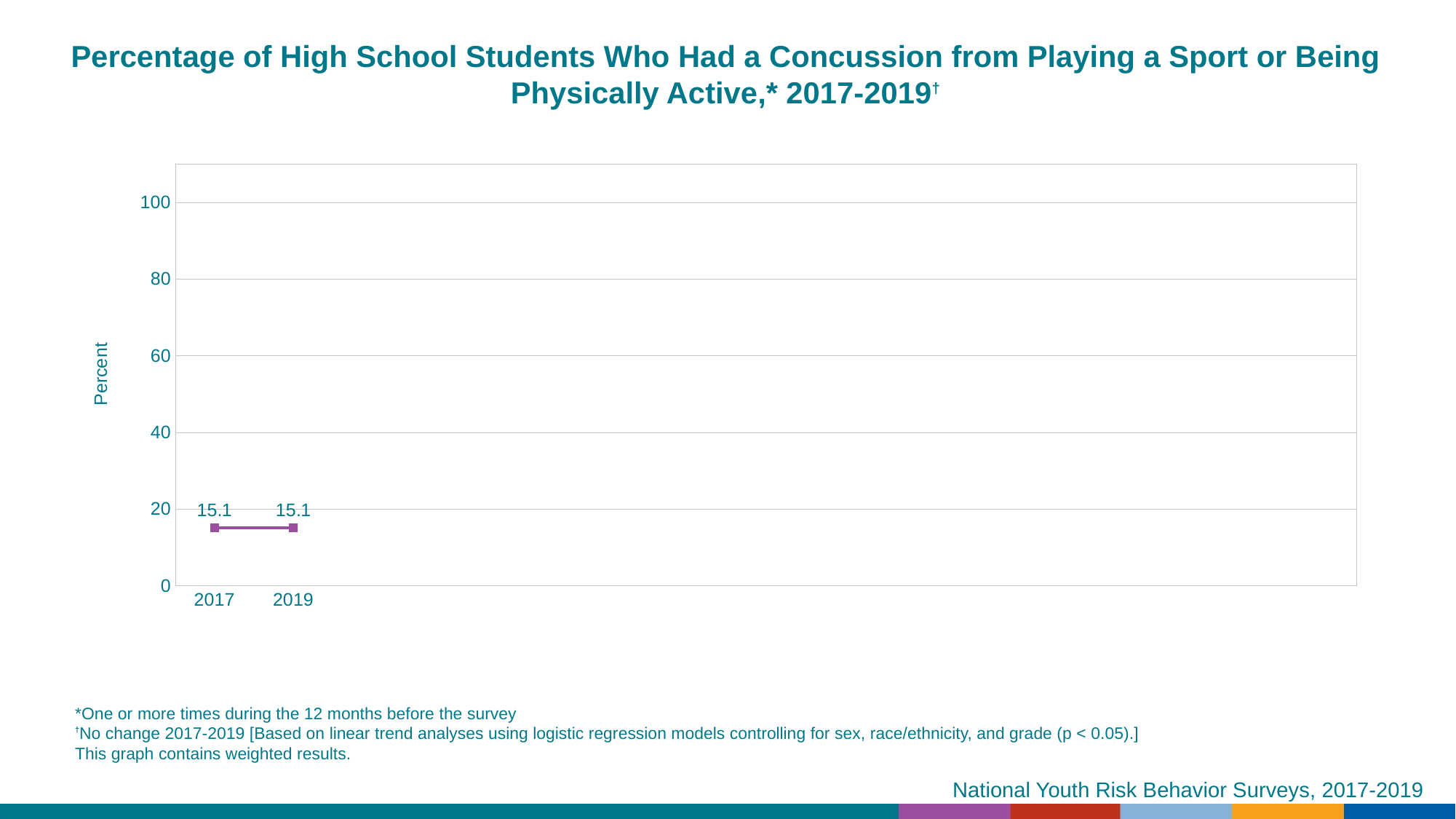
How many data points are plotted on the chart? 2 Is the value for 2017 greater or less than 40? less Is the value for 2019 greater or less than 20? less What is the label on the y axis? Percent What is the difference between the 2017 and 2019 values? 0 What is the value for 2017? 15.1 What is the value for 2019? 15.1 What is the highest value shown on the y axis? 100 Do the values rise, fall, or stay the same from 2017 to 2019? stay the same What kind of chart is shown on the slide? line chart